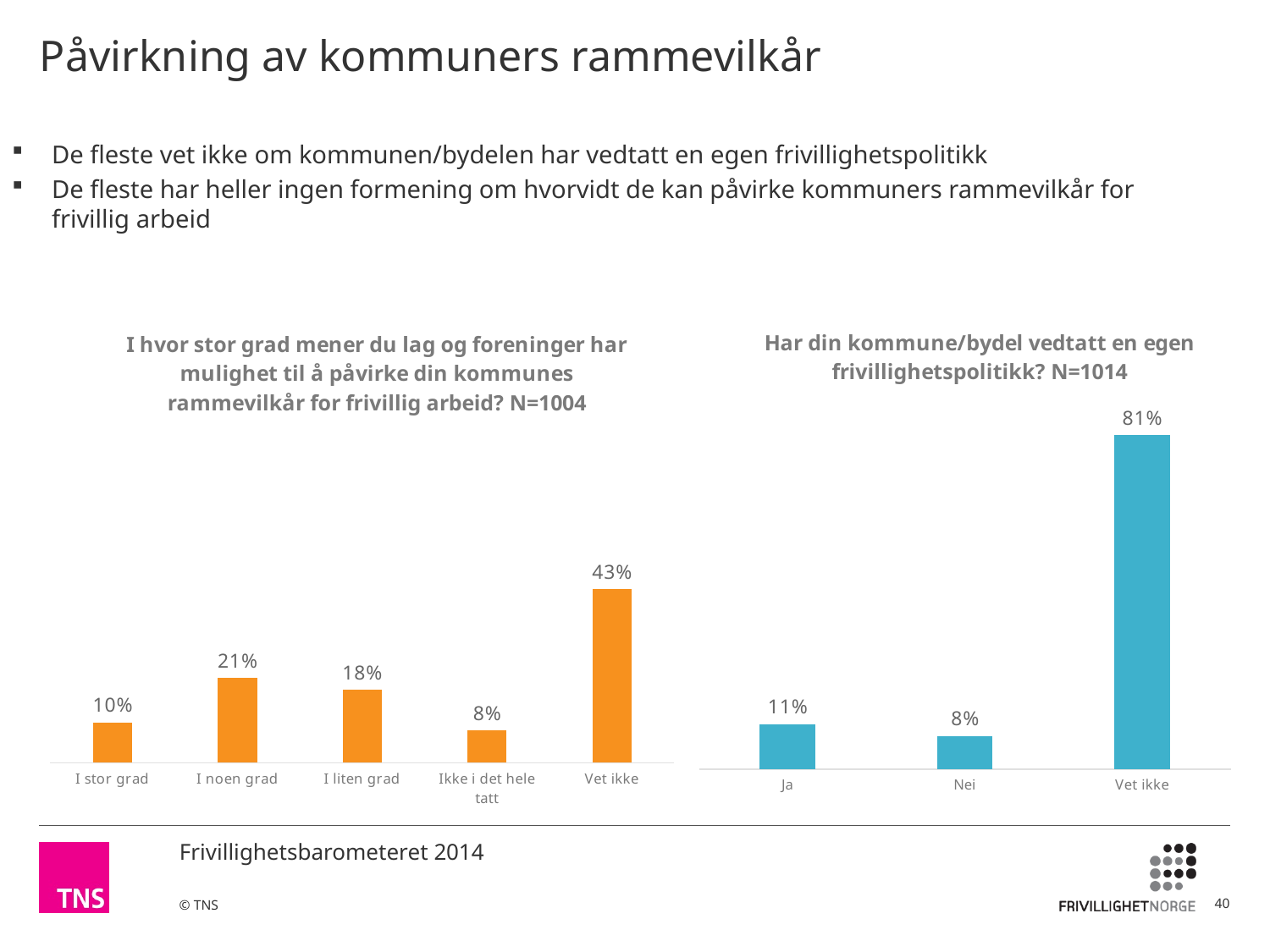
In the right chart, what is the value for 'Vet ikke'? 81% In the left chart, what is the value for 'Ikke i det hele tatt'? 8% What type of chart is the right chart? Bar chart In the left chart, which category has the highest value? Vet ikke What is the N (sample size) stated in the title of the right chart? N=1014 In the left chart, which category has the lowest value? Ikke i det hele tatt In the left chart, what is the difference between 'Vet ikke' and 'I stor grad'? 33% In the left chart, which is larger: 'I noen grad' or 'I liten grad'? I noen grad In the right chart, what is the difference between 'Ja' and 'Nei'? 3% In the left chart (I hvor stor grad mener du lag og foreninger har mulighet til å påvirke...), what is the value for 'I noen grad'? 21% How many categories are shown in the left chart? 5 In the right chart (Har din kommune/bydel vedtatt en egen frivillighetspolitikk?), what is the value for 'Ja'? 11%